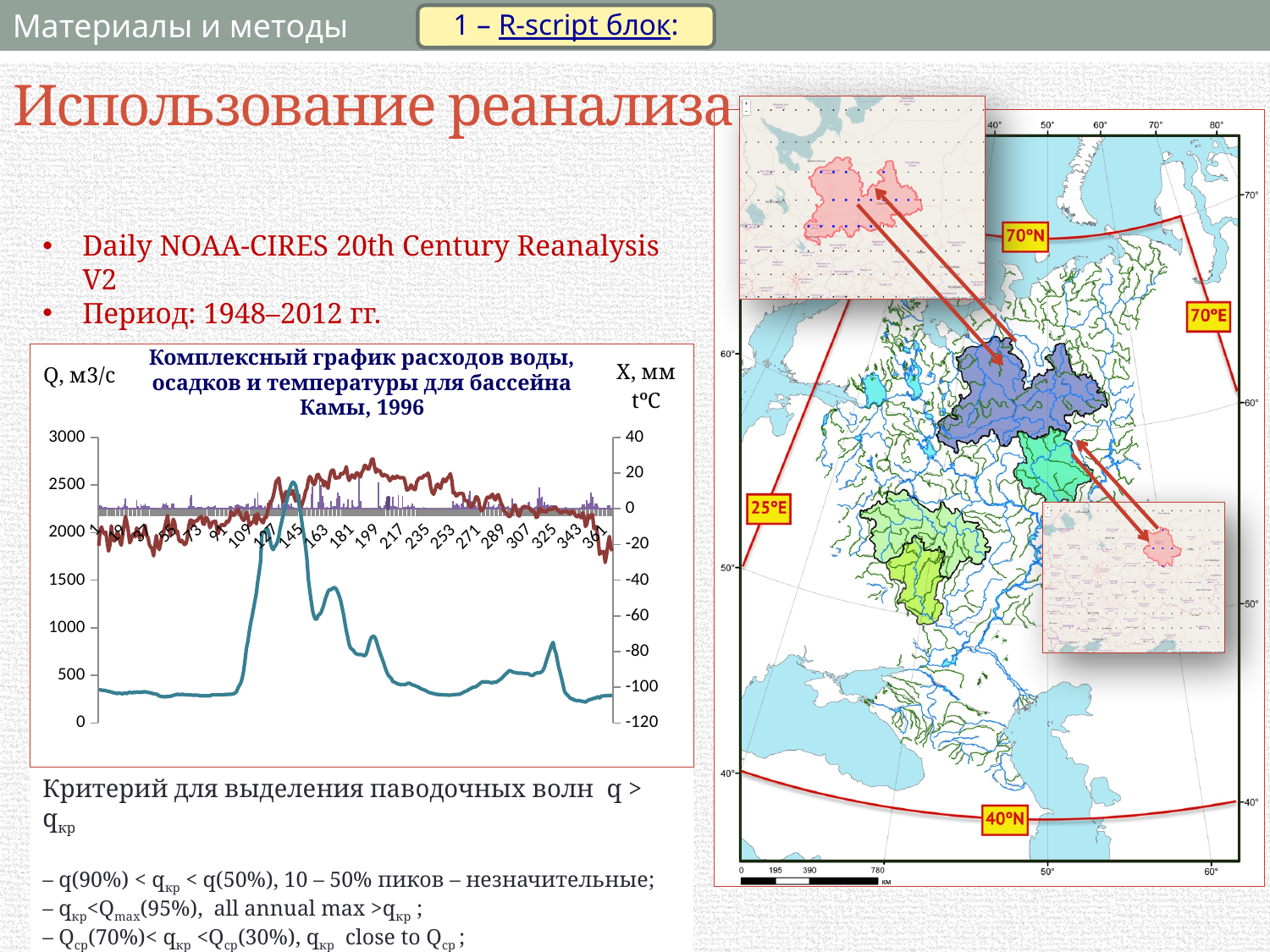
What is the lowest value shown on the right vertical axis of the chart? -120 What is the last tick label on the x axis of the chart? 361 Does the discharge (teal line) rise or fall between x = 163 and x = 253? fall What is the first tick label on the x axis of the chart? 1 Is the discharge (teal line) value at x = 361 greater or less than 1000 on the left axis? less What is the highest value shown on the left vertical axis of the chart? 3000 What kind of chart is shown on the slide? A combination chart with lines and bars Is the discharge (teal line) value at x = 1 greater or less than 500 on the left axis? less Does the discharge (teal line) rise or fall between x = 109 and x = 145? rise How many tick labels are printed along the x axis of the chart? 21 What is the title of the chart on the slide? Комплексный график расходов воды, осадков и температуры для бассейна Камы, 1996 What is the label of the left vertical axis of the chart? Q, м3/с